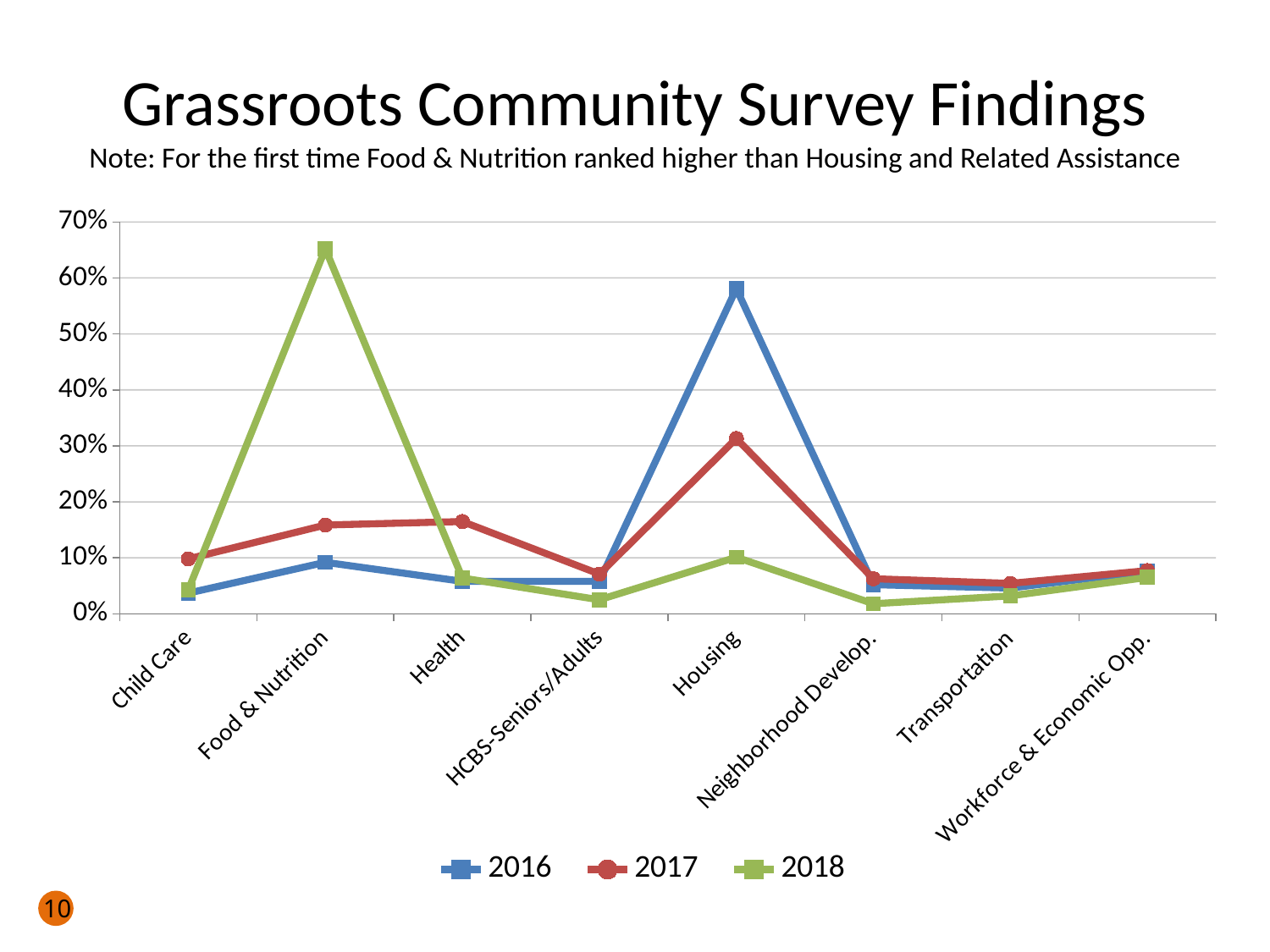
How many series does the legend list? 3 Which category has the highest value for the 2017 series? Housing What is the title of the chart on the slide? Grassroots Community Survey Findings Is the 2016 value for Housing greater or less than 50%? greater How many categories are shown along the x axis? 8 For Food & Nutrition, which series has the larger value, 2017 or 2018? 2018 Is the 2017 value for Housing greater or less than 40%? less Which category has the highest value for the 2018 series? Food & Nutrition Is the 2018 value for Food & Nutrition greater or less than 60%? greater For Housing, which series has the larger value, 2016 or 2017? 2016 Which category has the highest value for the 2016 series? Housing What kind of chart is shown on the slide? line chart